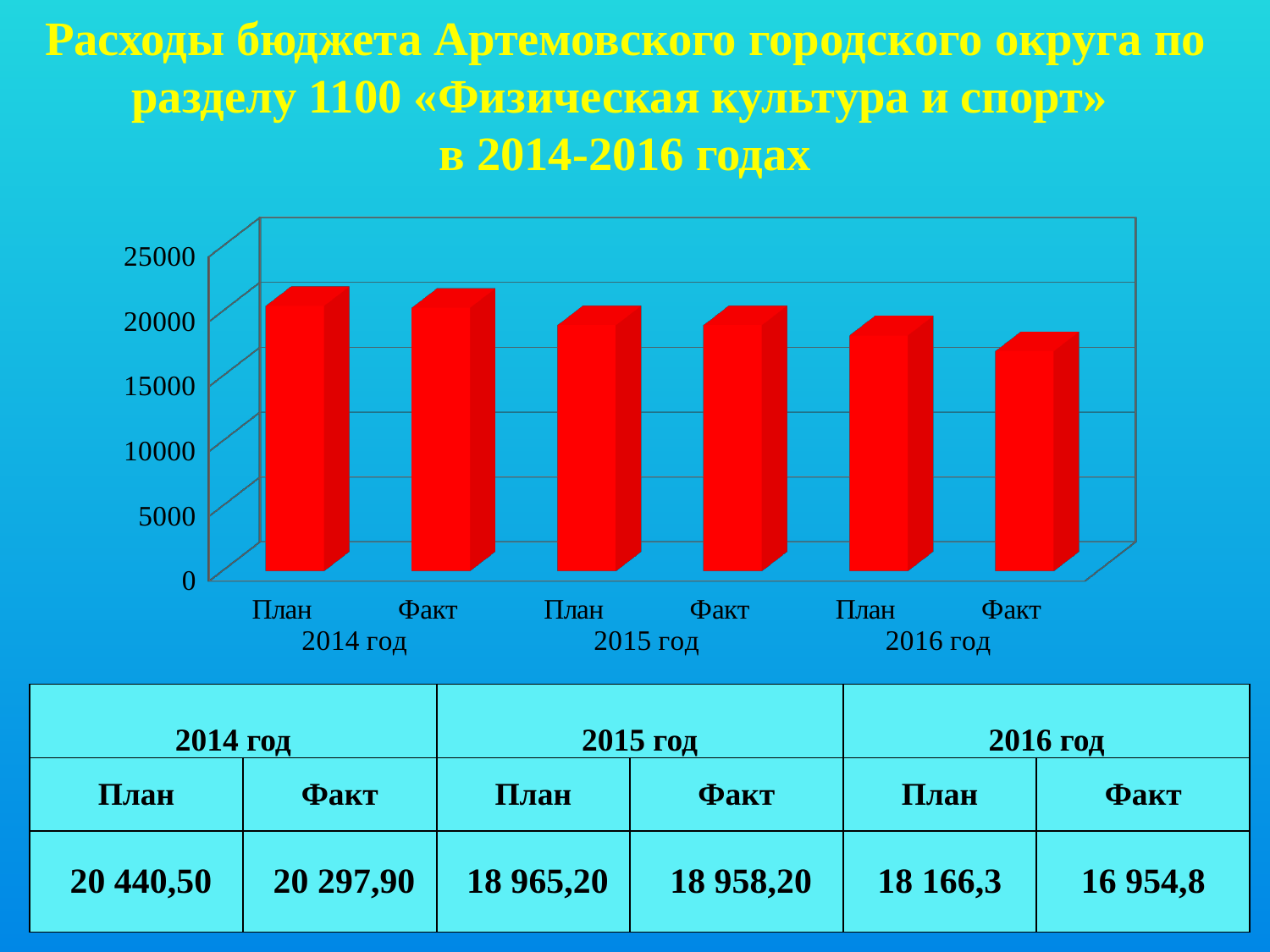
What is the difference between План and Факт for 2014 год? 142,60 Which bar has the highest value? План 2014 год Which bar has the lowest value? Факт 2016 год What kind of chart is shown on the slide? bar chart What is the planned (План) value for 2014 год? 20 440,50 Which is larger: План 2014 год or План 2016 год? План 2014 год Do the values generally rise or fall from 2014 год to 2016 год? fall How many bars are shown in the chart? 6 What is the difference between План and Факт for 2016 год? 1 211,5 Is the value for Факт 2016 год greater or less than 20000? less What is the actual (Факт) value for 2016 год? 16 954,8 What is the actual (Факт) value for 2015 год? 18 958,20